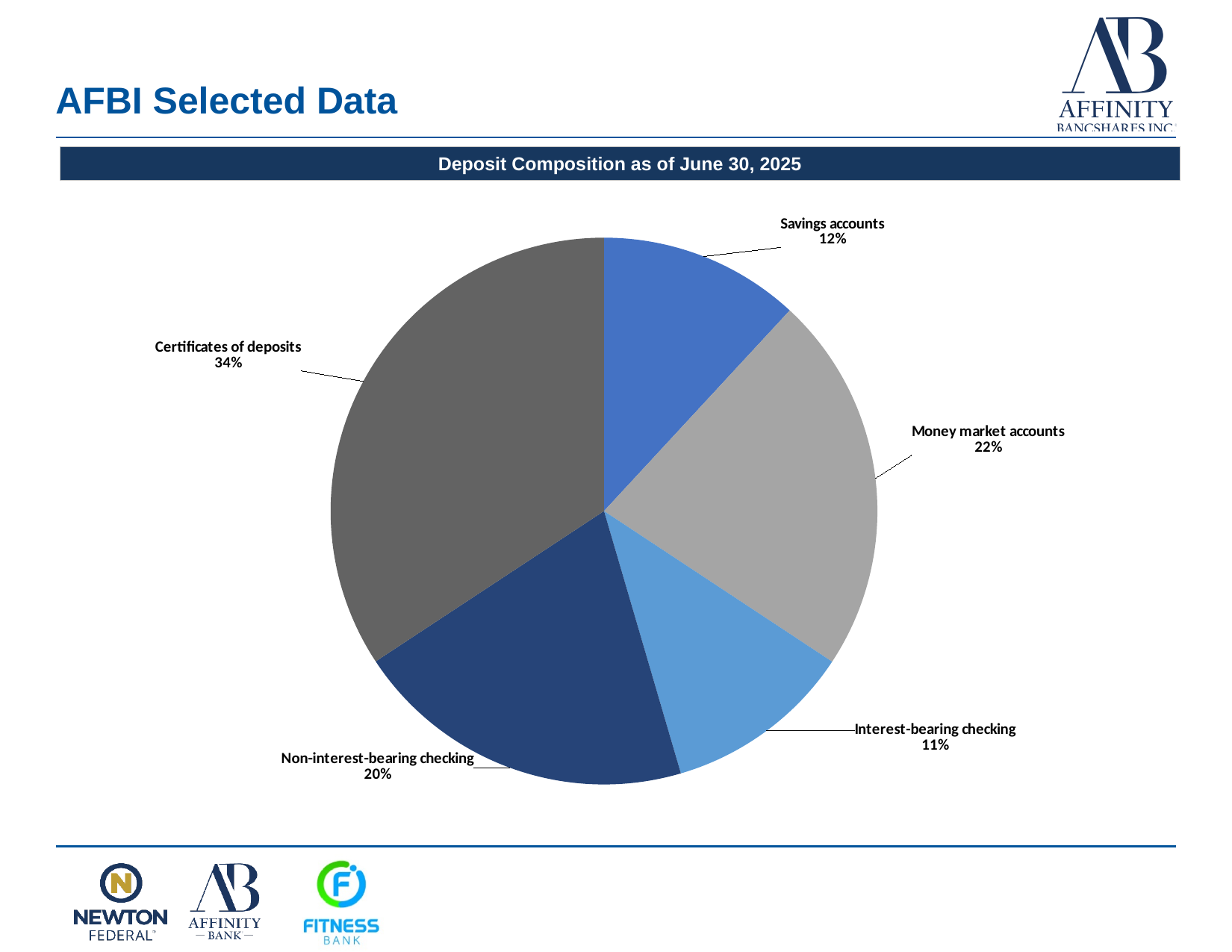
Which deposit category has the smallest share? Interest-bearing checking What share of deposits is in interest-bearing checking? 11% What share of deposits is in money market accounts? 22% How many deposit categories are shown in the pie chart? 5 Which deposit category has the largest share? Certificates of deposits What share of deposits is in savings accounts? 12% What is the title of the chart? Deposit Composition as of June 30, 2025 What is the difference in percentage points between certificates of deposits and money market accounts? 12 What kind of chart is shown on the slide? Pie chart Which is larger, the share for non-interest-bearing checking or the share for savings accounts? Non-interest-bearing checking